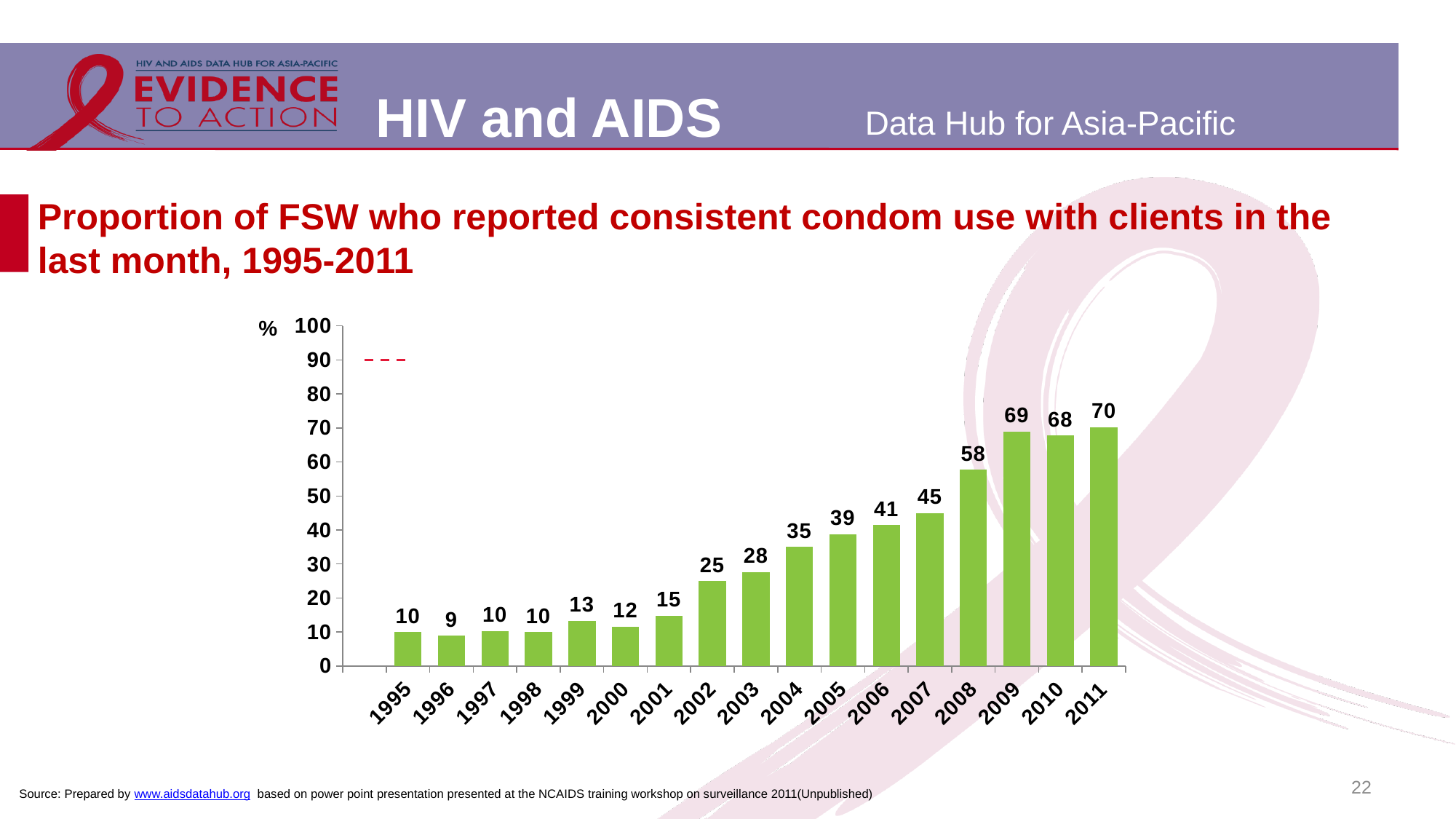
What is the value for 2002? 25 Is the value for 2006 greater or less than 50? less Do the values generally rise or fall from 1995 to 2011? rise Which year has the highest value? 2011 What is the value for 2011? 70 What is the difference between the values for 2011 and 1995? 60 Which year has the lowest value? 1996 Which is larger, the value for 2005 or the value for 2007? 2007 What kind of chart is shown on the slide? bar chart What is the value for 2008? 58 How many years are shown on the x axis? 17 What is the difference between the values for 2009 and 2008? 11